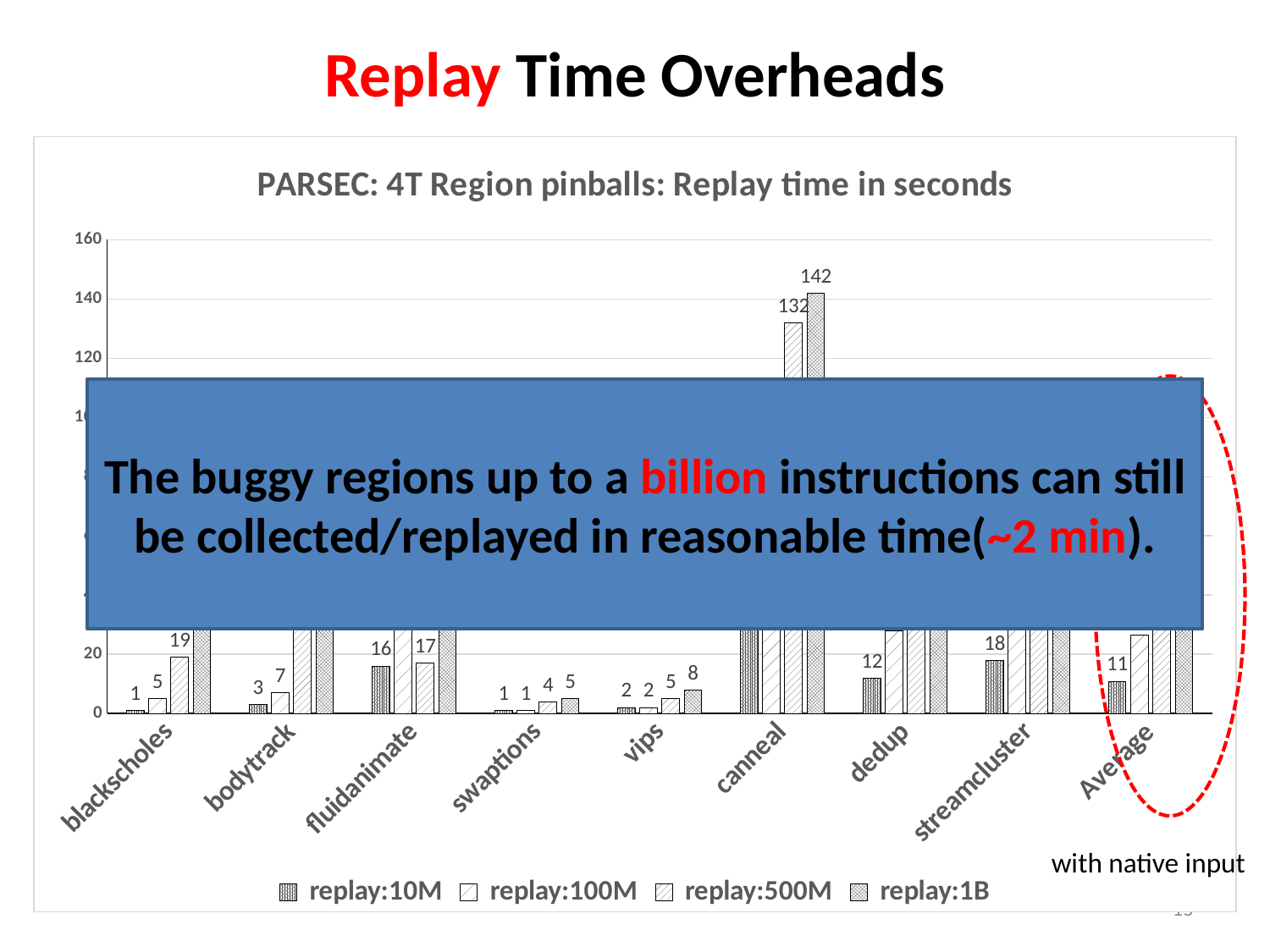
Which is larger, the replay:1B value for swaptions or the replay:1B value for vips? vips What is the replay:500M value for blackscholes? 19 How many series does the legend list? 4 What kind of chart is shown on the slide? bar chart Which category has the highest replay:1B value? canneal What is the replay:1B value for canneal? 142 What is the replay:500M value for canneal? 132 What is the replay:10M value for streamcluster? 18 What is the replay:1B value for vips? 8 What is the difference between the replay:1B and replay:500M values for canneal? 10 What is the title of the chart? PARSEC: 4T Region pinballs: Replay time in seconds How many categories are shown on the x axis? 9